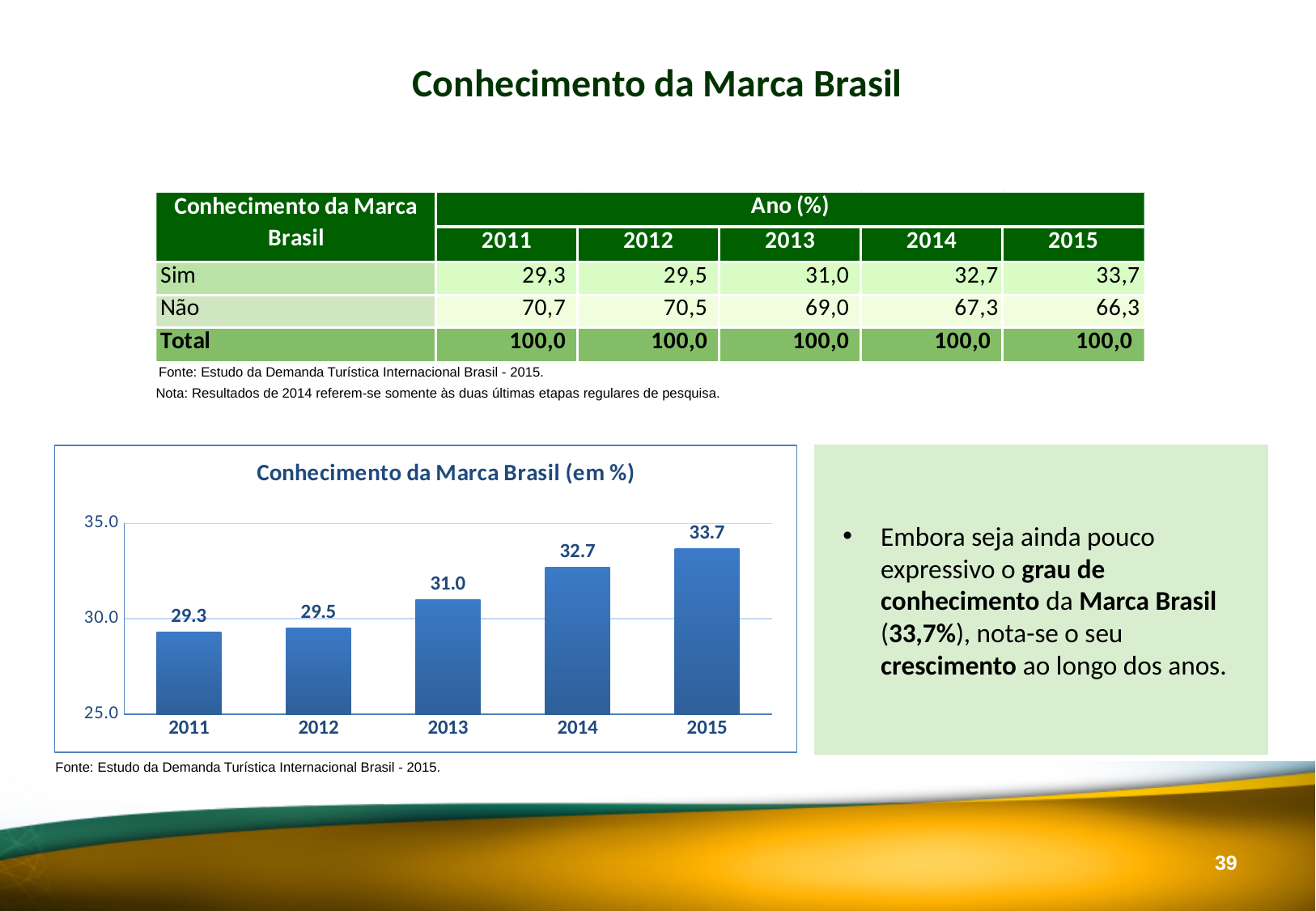
Which is larger, the value for 2012 or the value for 2014? 2014 Which year has the highest value in the chart? 2015 What is the value for 2011 in the chart? 29.3 What is the value for 2015 in the chart? 33.7 What kind of chart is shown on the slide? bar chart Is the value for 2013 greater or less than 30.0? greater Do the values rise or fall from 2011 to 2015? rise What is the difference between the values for 2015 and 2011? 4.4 How many years are shown on the x axis of the chart? 5 Which year has the lowest value in the chart? 2011 What is the difference between the values for 2014 and 2013? 1.7 What is the value for 2013 in the chart? 31.0